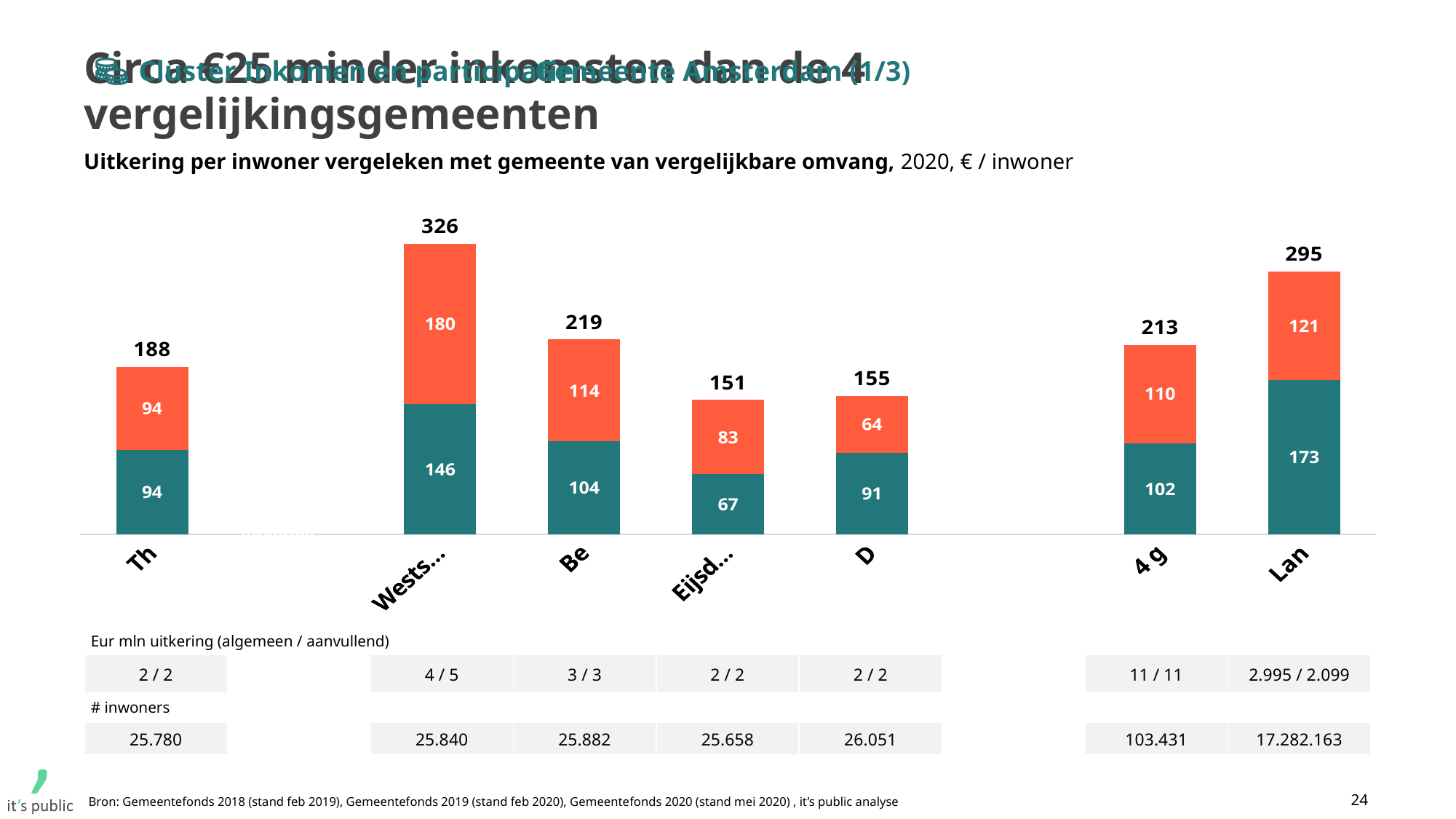
What is the value of the teal (bottom) segment of the bar for Lan? 173 What is the total value shown above the bar for Th? 188 What unit is stated in the chart subtitle for the values? € / inwoner What kind of chart is shown on the slide? Stacked bar chart How many bars are shown in the chart? 7 What is the difference between the total for Lan and the total for 4 g? 82 Which category has the highest total value? Wests... What is the value of the orange (top) segment of the bar for Be? 114 What is the value of the orange (top) segment of the bar for D? 64 Which has a larger total value, Be or D? Be Which category has the lowest total value? Eijsd... What is the sum of the two segments of the bar for Wests...? 326